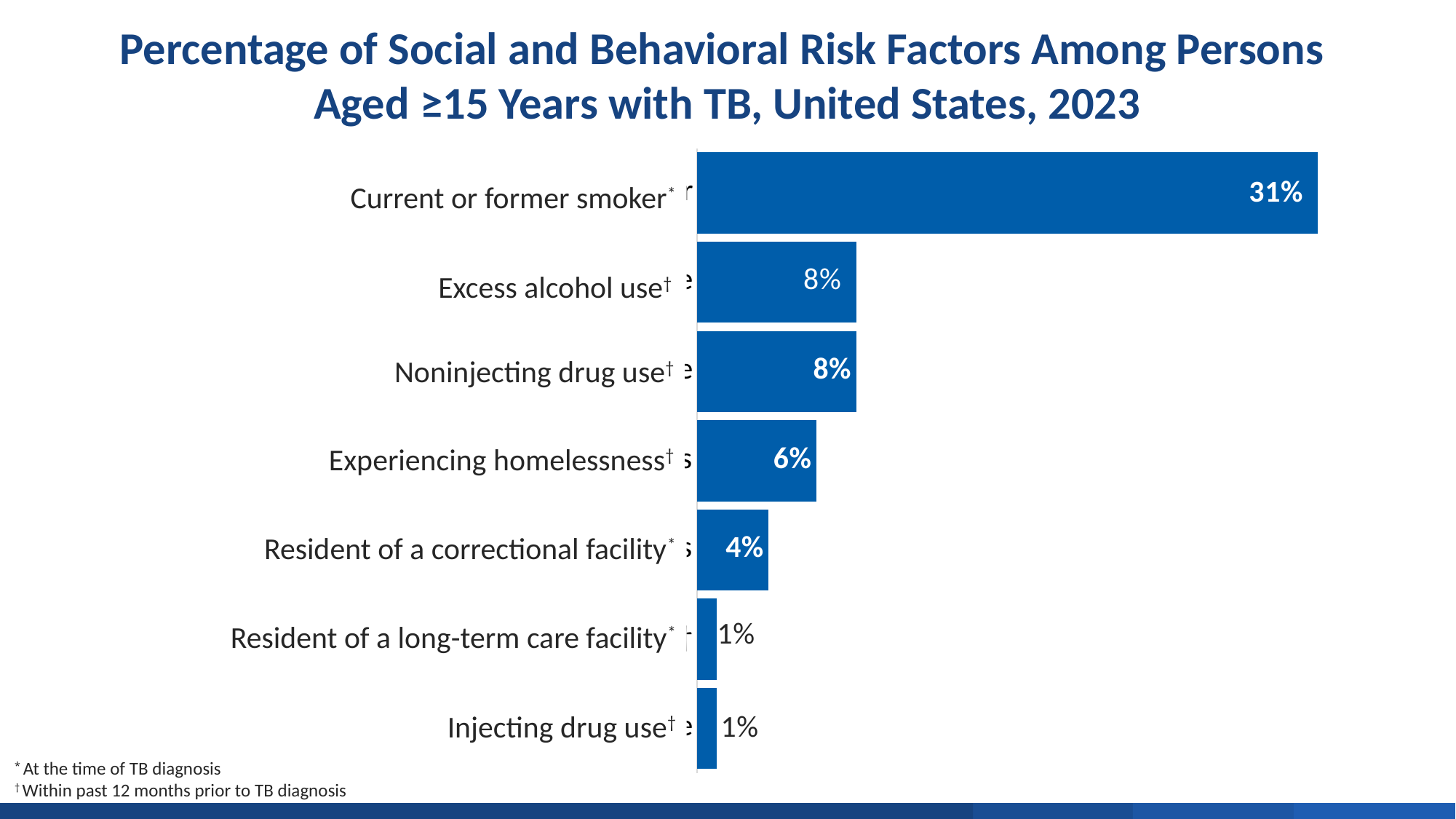
Which risk factor has the highest percentage? Current or former smoker What kind of chart is shown on the slide? Bar chart What is the difference in percentage points between Current or former smoker and Excess alcohol use? 23 What is the difference in percentage points between Experiencing homelessness and Resident of a correctional facility? 2 What percentage is shown for Excess alcohol use? 8% Which is larger, the value for Noninjecting drug use or the value for Experiencing homelessness? Noninjecting drug use What percentage is shown for Experiencing homelessness? 6% What is the title of the chart? Percentage of Social and Behavioral Risk Factors Among Persons Aged ≥15 Years with TB, United States, 2023 What percentage is shown for Resident of a correctional facility? 4% Which is larger, the value for Resident of a correctional facility or the value for Injecting drug use? Resident of a correctional facility What percentage is shown for Current or former smoker? 31% How many risk factor categories are shown in the chart? 7